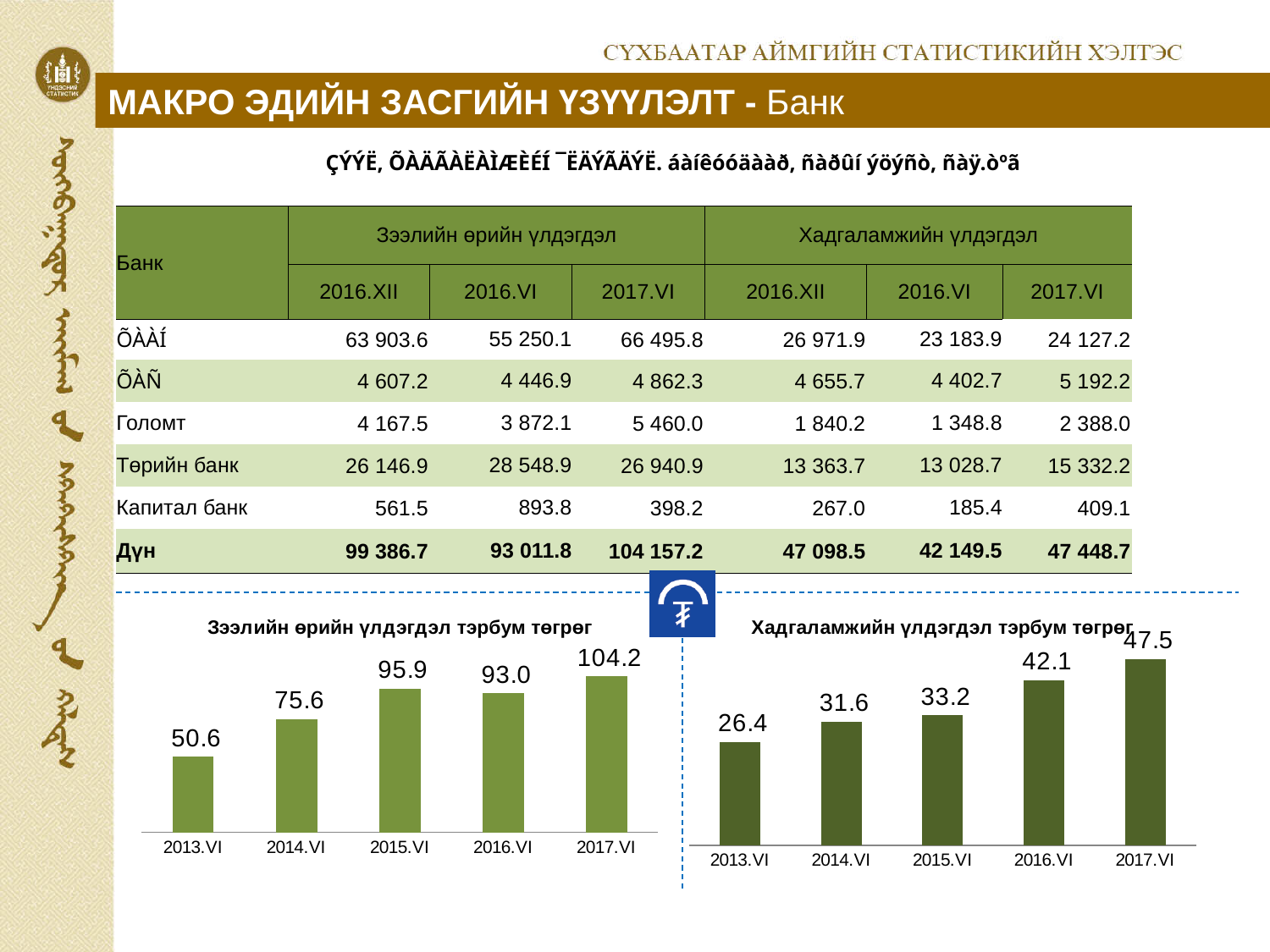
In the left chart (Зээлийн өрийн үлдэгдэл тэрбум төгрөг), which period has the highest value? 2017.VI In the left chart (Зээлийн өрийн үлдэгдэл тэрбум төгрөг), what is the difference between the values for 2017.VI and 2013.VI? 53.6 In the left chart (Зээлийн өрийн үлдэгдэл тэрбум төгрөг), what is the value for 2013.VI? 50.6 In the right chart (Хадгаламжийн үлдэгдэл тэрбум төгрөг), what is the value for 2015.VI? 33.2 In the left chart (Зээлийн өрийн үлдэгдэл тэрбум төгрөг), which is larger, the value for 2015.VI or 2016.VI? 2015.VI How many bars are shown in the right chart (Хадгаламжийн үлдэгдэл тэрбум төгрөг)? 5 In the right chart (Хадгаламжийн үлдэгдэл тэрбум төгрөг), what is the value for 2017.VI? 47.5 In the right chart (Хадгаламжийн үлдэгдэл тэрбум төгрөг), which period has the lowest value? 2013.VI What type of chart is the left chart (Зээлийн өрийн үлдэгдэл тэрбум төгрөг)? Bar chart In the right chart (Хадгаламжийн үлдэгдэл тэрбум төгрөг), do the values rise or fall from 2013.VI to 2017.VI? Rise In the left chart (Зээлийн өрийн үлдэгдэл тэрбум төгрөг), what is the value for 2016.VI? 93.0 In the right chart (Хадгаламжийн үлдэгдэл тэрбум төгрөг), what is the difference between the values for 2016.VI and 2015.VI? 8.9